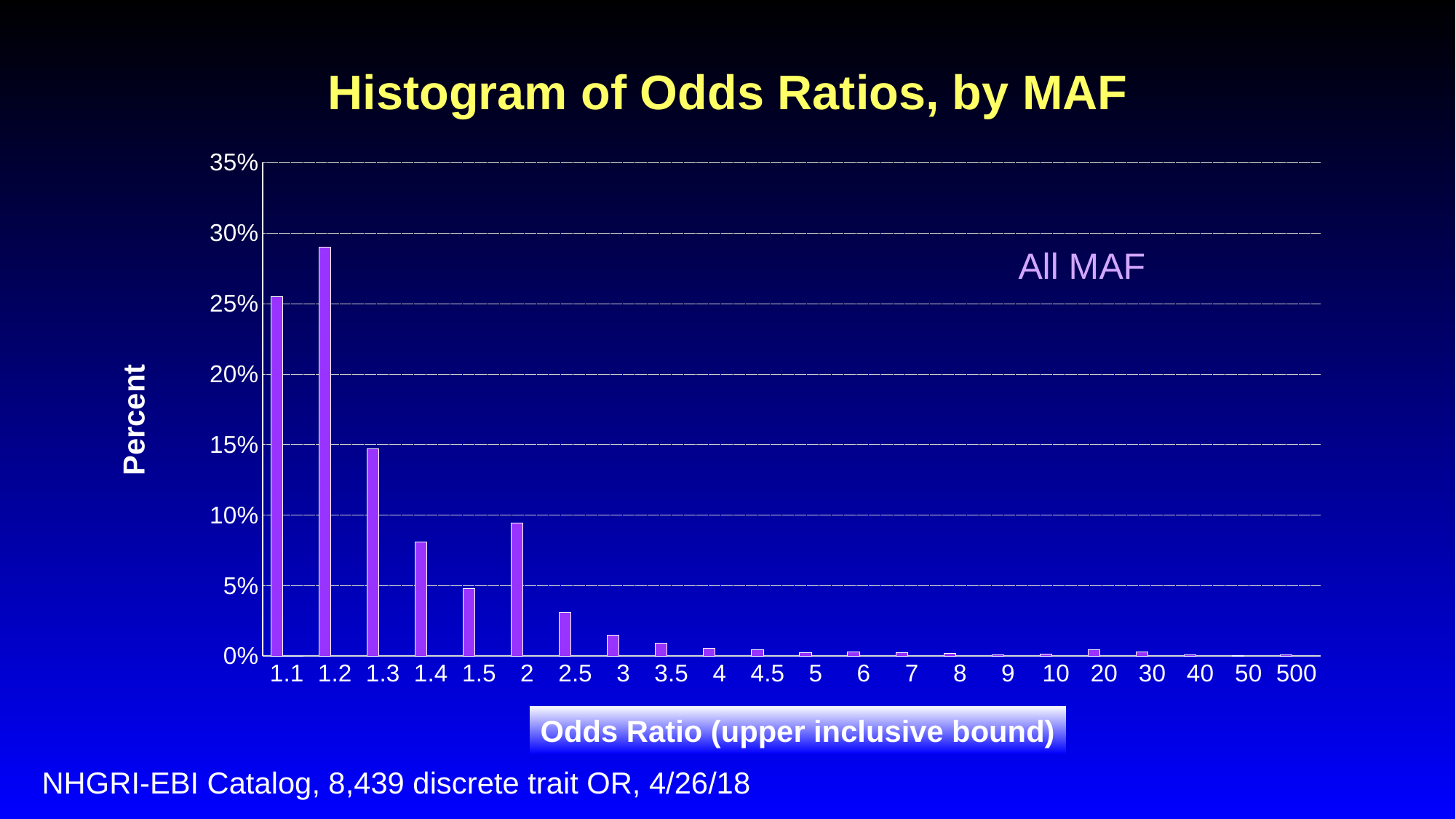
What is the label of the y axis? Percent Is the value for odds ratio 1.1 greater or less than 20%? greater Is the value for odds ratio 1.2 greater or less than 25%? greater Is the value for odds ratio 2.5 greater or less than 5%? less How many odds ratio categories are shown on the x axis? 22 Which has a higher percent, odds ratio 1.4 or odds ratio 2? 2 Do the percent values generally rise or fall as the odds ratio increases along the x axis? fall What kind of chart is shown on the slide? bar chart Which odds ratio category has the highest percent? 1.2 Which has a higher percent, odds ratio 1.1 or odds ratio 1.2? 1.2